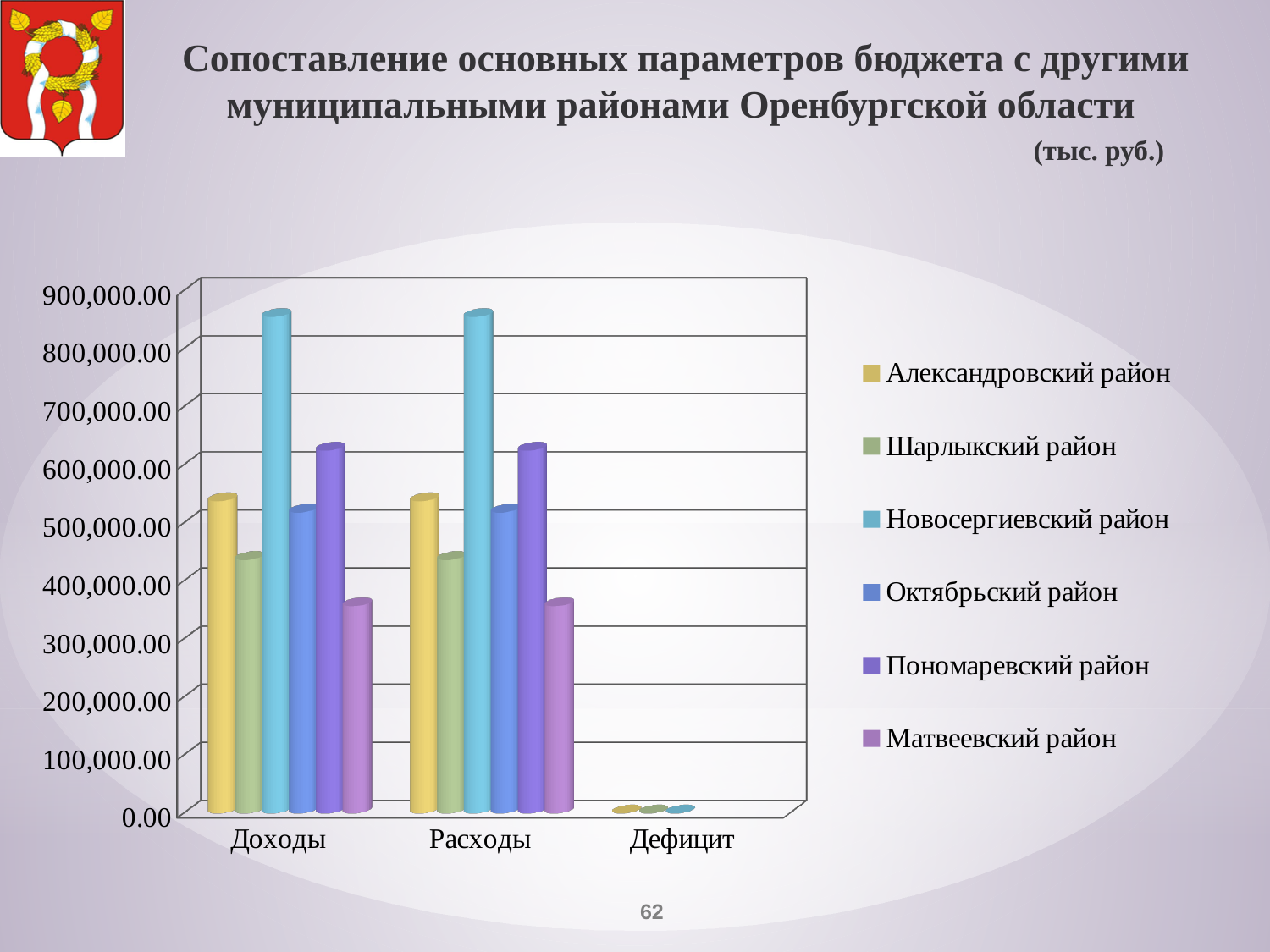
What kind of chart is shown on the slide? bar chart For Расходы, which is larger: Александровский район or Матвеевский район? Александровский район Is the value for Новосергиевский район under Доходы greater or less than 800,000.00? greater How many categories are shown on the x axis of the chart? 3 Is the value for Пономаревский район under Расходы greater or less than 500,000.00? greater Which district has the lowest value for Расходы? Матвеевский район Is the value for Матвеевский район under Доходы greater or less than 400,000.00? less Which district has the highest value for Доходы? Новосергиевский район In what units are the values on the chart given, according to the slide? тыс. руб. How many series does the chart legend list? 6 For Доходы, which is larger: Пономаревский район or Шарлыкский район? Пономаревский район